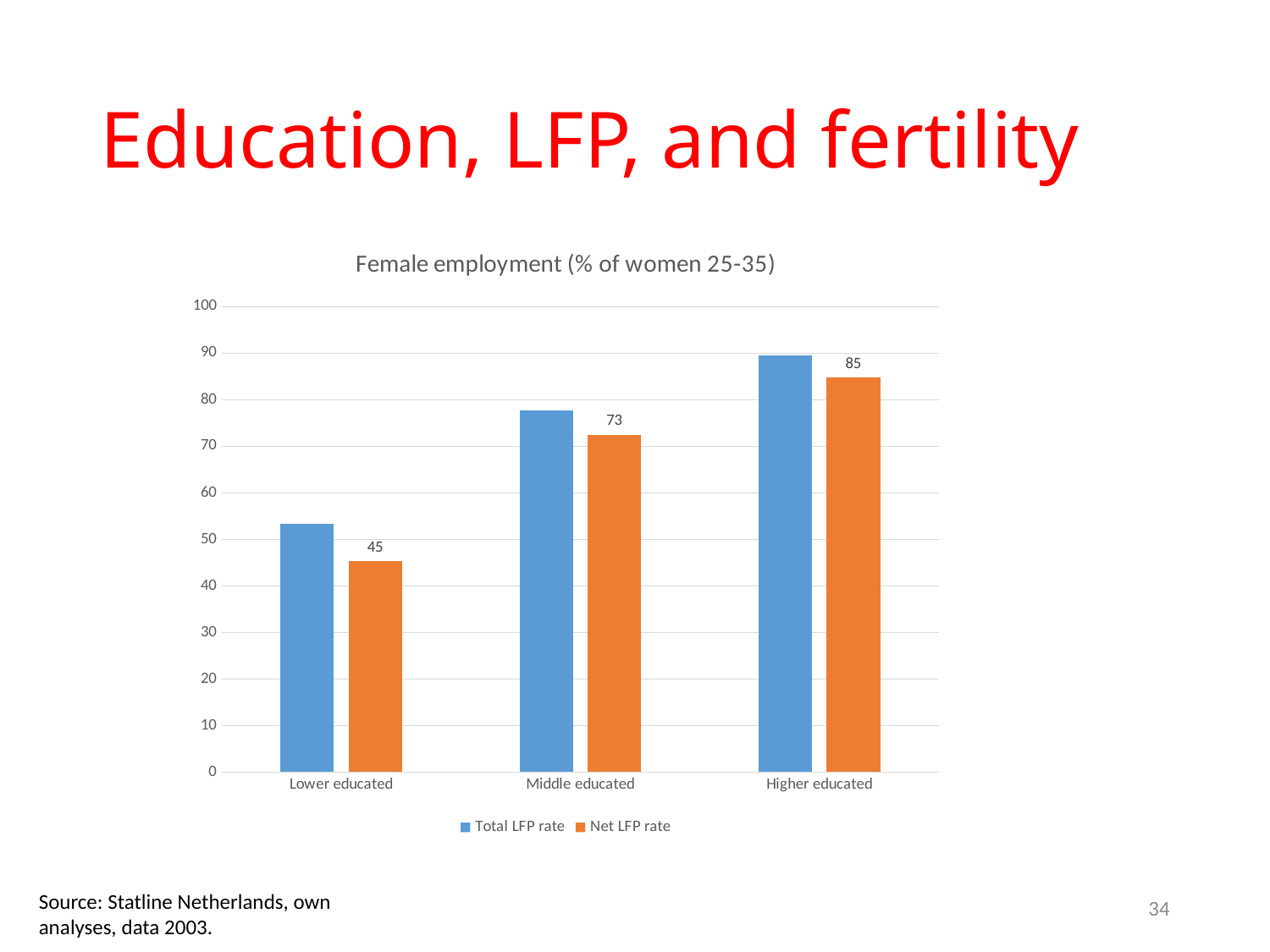
How many education categories are shown on the x axis? 3 What is the Net LFP rate for Lower educated women? 45 Is the Total LFP rate for Lower educated women greater or less than 50? greater Is the Total LFP rate for Higher educated women greater or less than 80? greater For Middle educated women, which is larger: the Total LFP rate or the Net LFP rate? Total LFP rate Which education group has the lowest Net LFP rate? Lower educated What type of chart is shown on the slide? Bar chart How many series does the legend list? 2 Which education group has the highest Net LFP rate? Higher educated What is the Net LFP rate for Middle educated women? 73 What is the Net LFP rate for Higher educated women? 85 What is the difference between the Net LFP rate for Higher educated and Lower educated women? 40